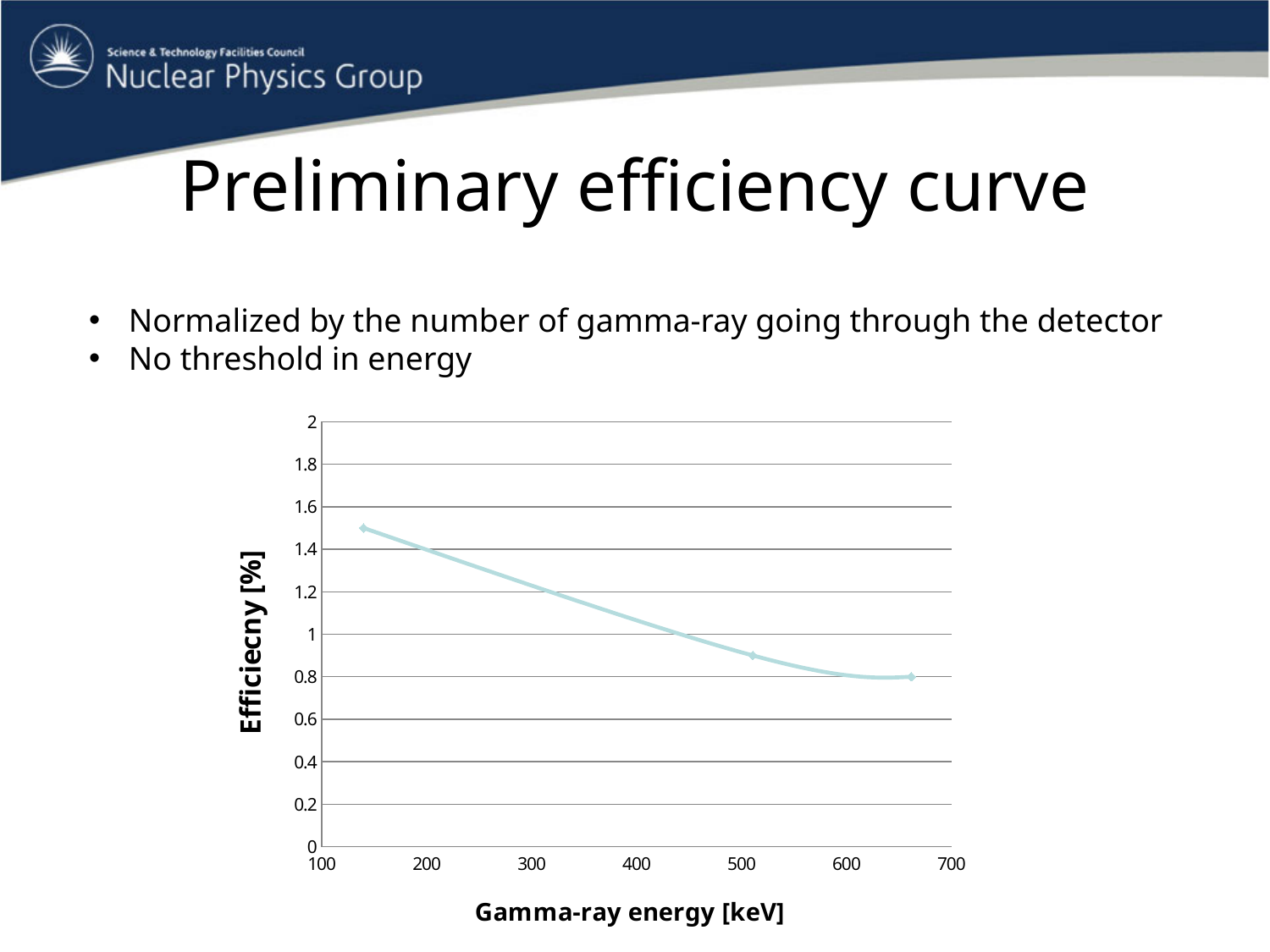
How many data points are plotted on the efficiency curve? 3 Does the efficiency rise or fall as gamma-ray energy increases along the x axis? fall What is the title of the y axis of the chart? Efficiecny [%] What is the title of the x axis of the chart? Gamma-ray energy [keV] Is the efficiency value for the highest-energy data point greater or less than 1? less Is the efficiency value for the data point near 500 keV greater or less than 0.6? greater Is the efficiency value for the lowest-energy data point greater or less than 1.4? greater Which data point has the highest efficiency: the one near 140 keV or the one near 660 keV? the one near 140 keV What kind of chart is shown on the slide? line chart